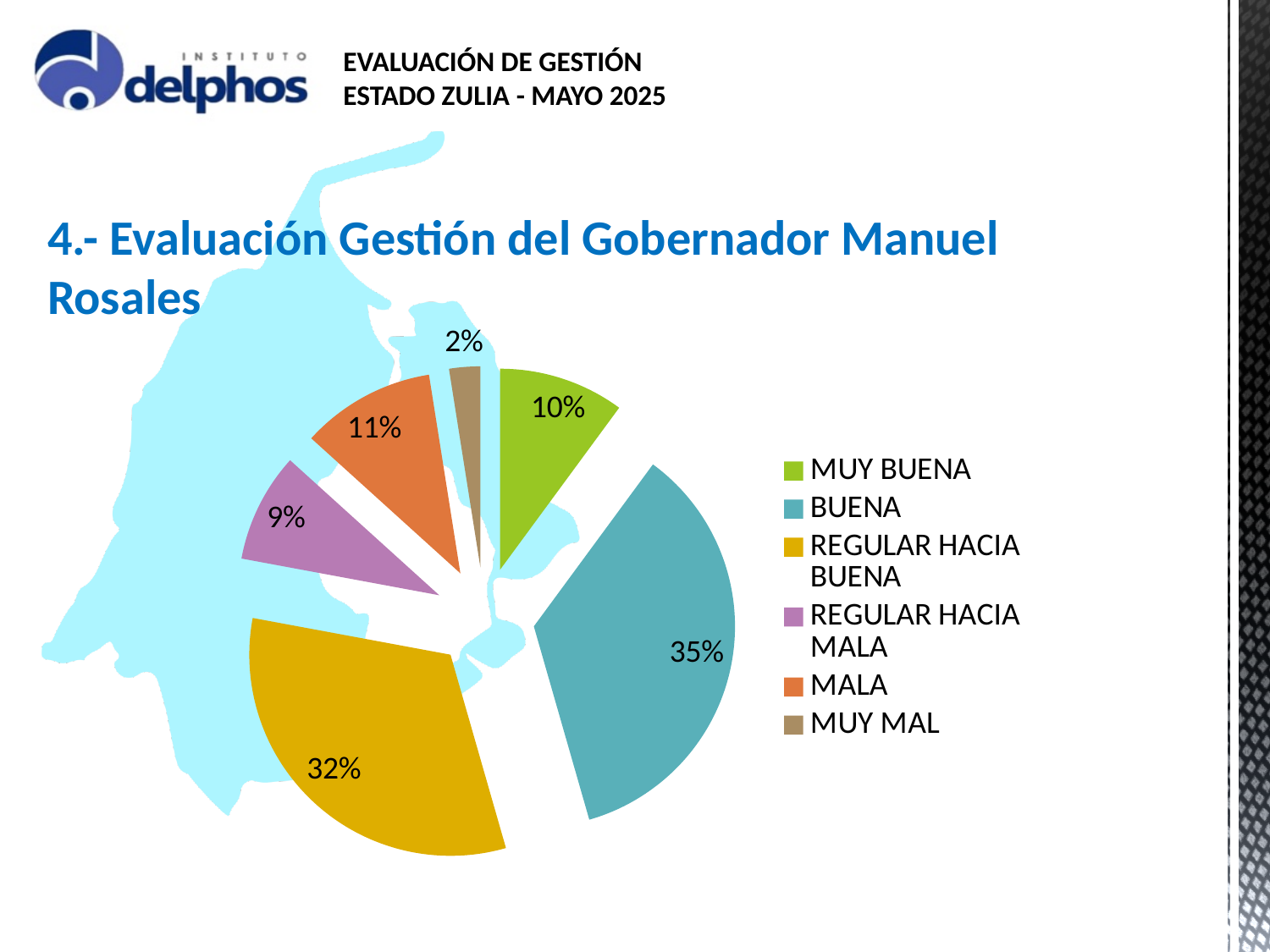
What percentage of respondents rated the governor's management as BUENA? 35% What is the difference between the BUENA and REGULAR HACIA BUENA shares? 3% What colour is the BUENA slice in the pie chart? Teal How many categories does the pie chart have? 6 What is the value for MUY BUENA? 10% What is the combined share of MALA and MUY MAL? 13% What is the value for MUY MAL? 2% What kind of chart is shown on the slide? Pie chart What percentage corresponds to REGULAR HACIA BUENA? 32% Which category has the smallest share of the pie? MUY MAL Which category has the largest share of the pie? BUENA Which is larger, MALA or REGULAR HACIA MALA? MALA